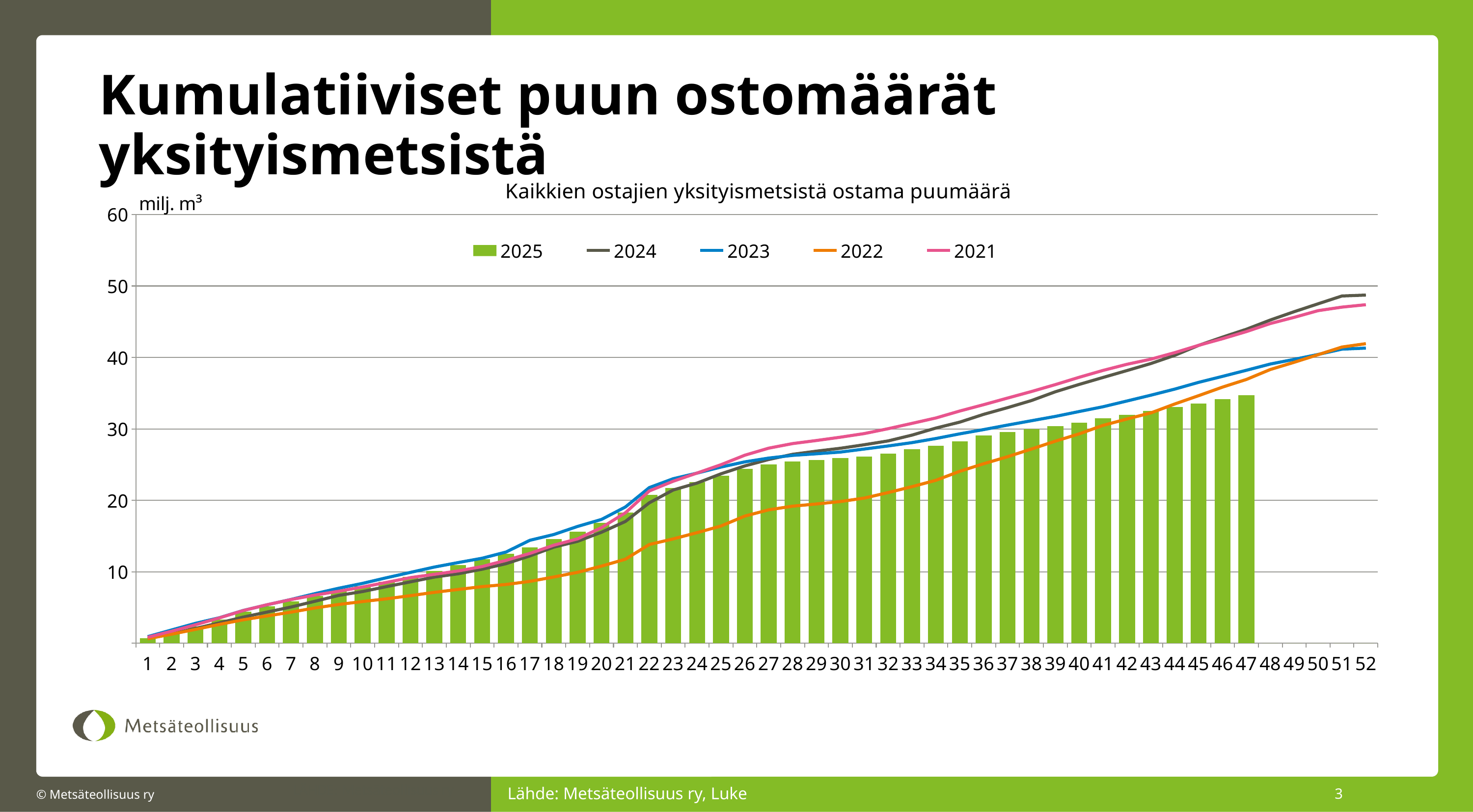
At week 30, which is larger, the 2022 value or the 2021 value? 2021 How many series does the legend list? 5 Is the 2024 value at week 52 greater or less than 50? less Is the 2025 value at week 47 greater or less than 30? greater Is the 2022 value at week 20 greater or less than 20? less Do the 2025 bars rise or fall along the x axis from week 1 to week 47? rise At week 52, which is larger, the 2024 value or the 2023 value? 2024 Which series is shown as bars rather than a line? 2025 How many week categories are shown on the x axis? 52 Which series has the highest value at week 52? 2024 What kind of chart is shown on the slide? bar and line chart